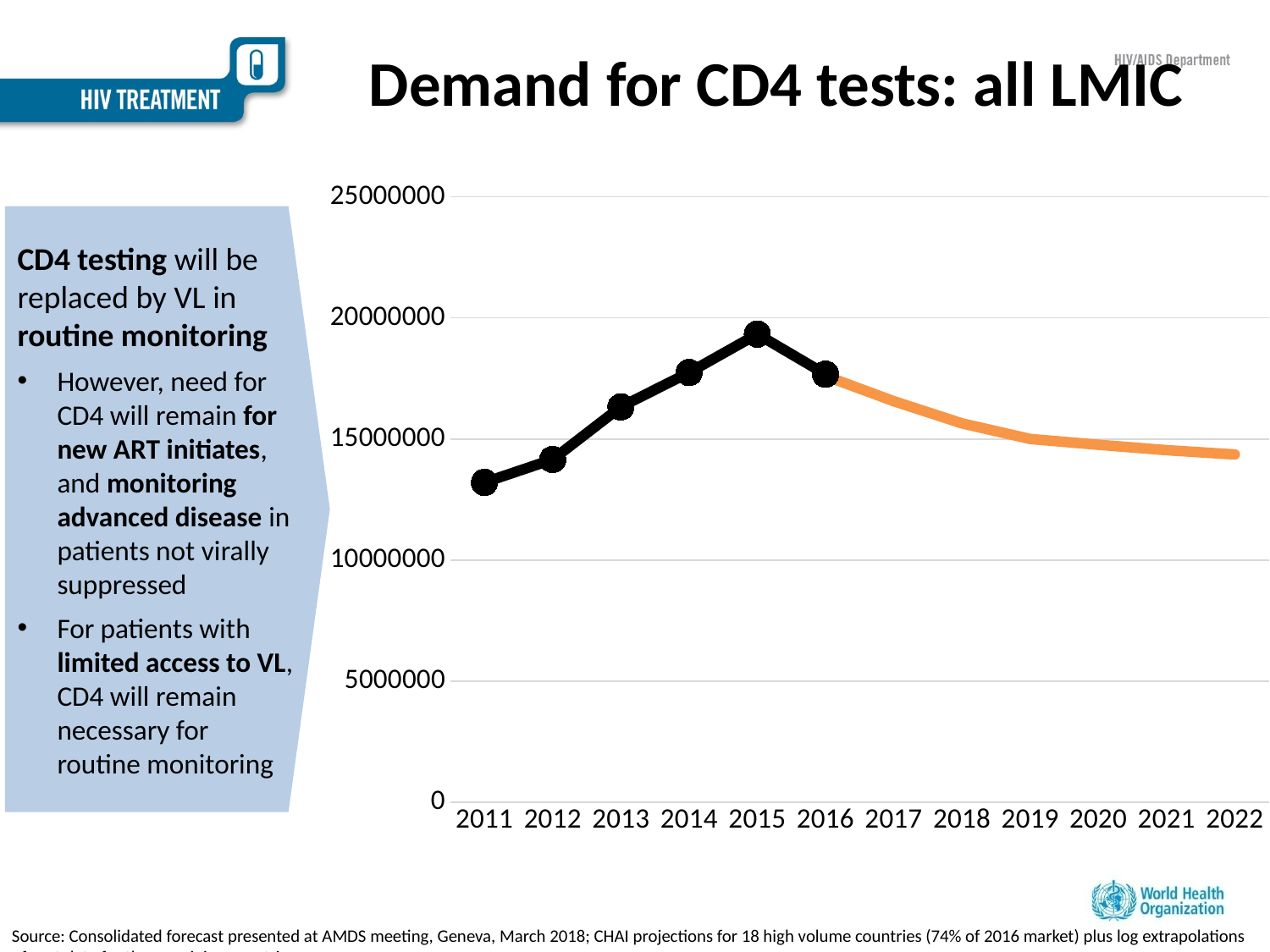
Do the values rise or fall from 2011 to 2015? rise How many years are shown on the x axis of the chart? 12 Is the value for 2015 greater or less than 20000000? less Is the value for 2022 greater or less than 10000000? greater Do the values rise or fall from 2016 to 2022? fall Which year has the highest demand for CD4 tests on the chart? 2015 What kind of chart is shown on the slide? line chart Which year has the lowest demand for CD4 tests on the chart? 2011 What is the title of the slide's chart? Demand for CD4 tests: all LMIC Which year has the larger value, 2013 or 2012? 2013 Is the value for 2011 greater or less than 15000000? less